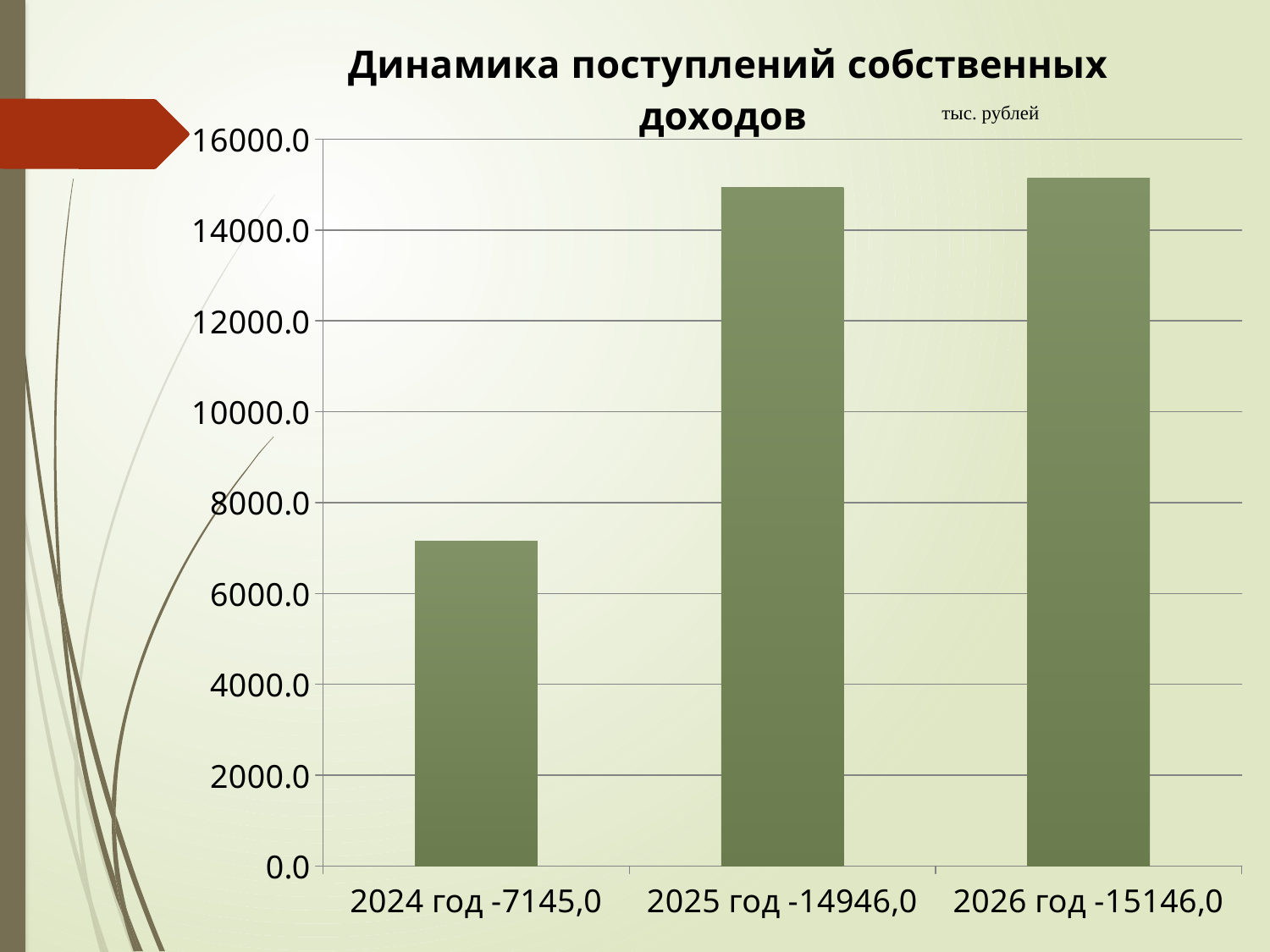
Which year has the highest value? 2026 год What kind of chart is shown on the slide? bar chart Is the value for 2024 год greater or less than 8000? less Which year has the lowest value? 2024 год What is the difference between the values for 2025 год and 2024 год? 7801,0 How many bars are shown in the chart? 3 Do the values rise or fall from 2024 to 2026? rise Which is larger, the value for 2024 год or the value for 2025 год? 2025 год What is the difference between the values for 2026 год and 2025 год? 200,0 What value is shown for 2026 год? 15146,0 What value is shown for 2025 год? 14946,0 What value is shown for 2024 год? 7145,0